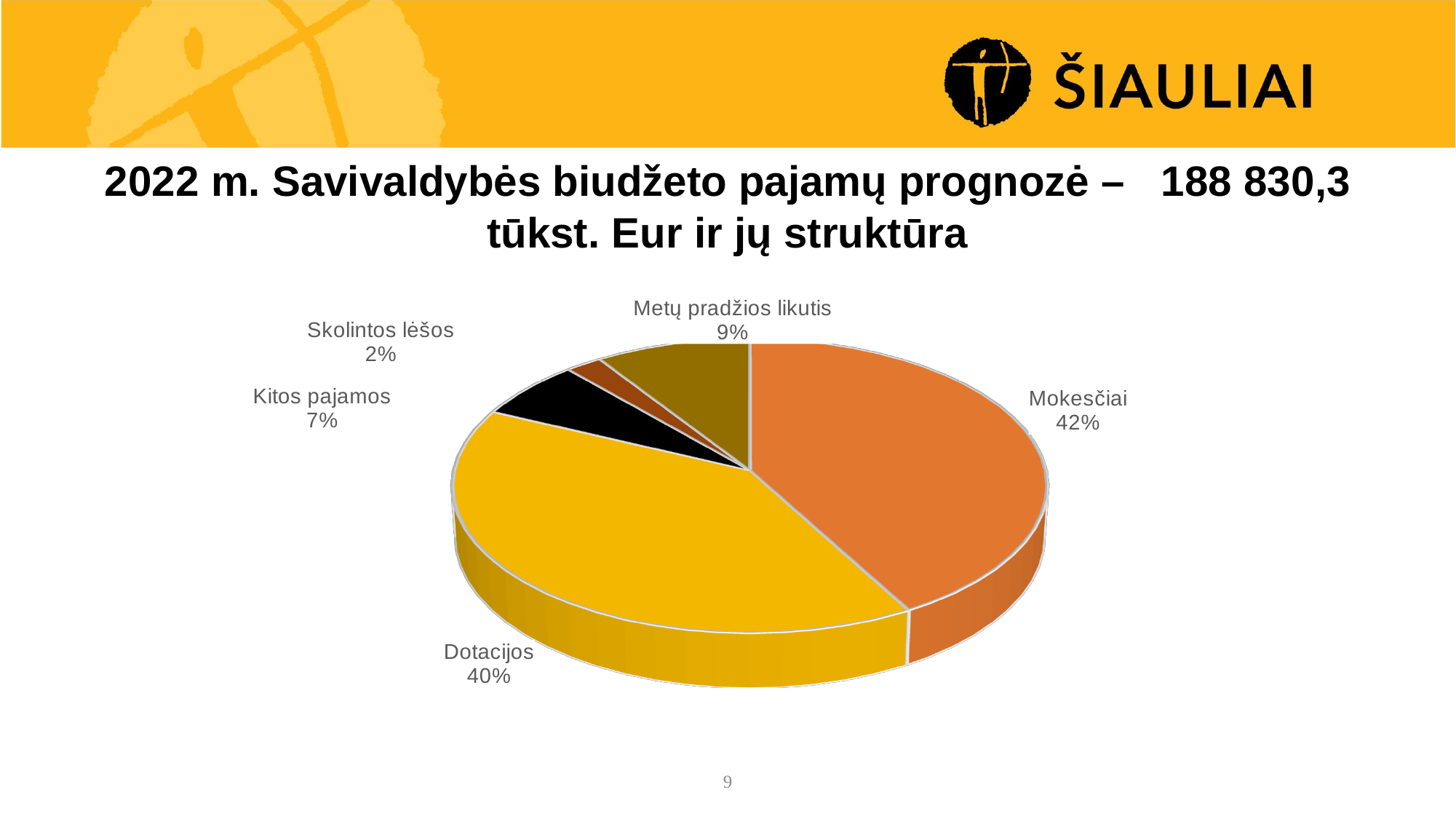
What percentage is shown for Metų pradžios likutis? 9% What is the difference in percentage points between Mokesčiai and Dotacijos? 2 What type of chart is shown on the slide? Pie chart What percentage is shown for Kitos pajamos? 7% Which category has the largest share of the pie? Mokesčiai Which category has the smallest share of the pie? Skolintos lėšos What total amount in tūkst. Eur is given in the slide title for the 2022 budget revenue forecast? 188 830,3 How many slices does the pie chart have? 5 What percentage is shown for Skolintos lėšos? 2% What share of the pie does Mokesčiai represent? 42% What share of the pie does Dotacijos represent? 40% Which is larger, the share for Metų pradžios likutis or the share for Kitos pajamos? Metų pradžios likutis